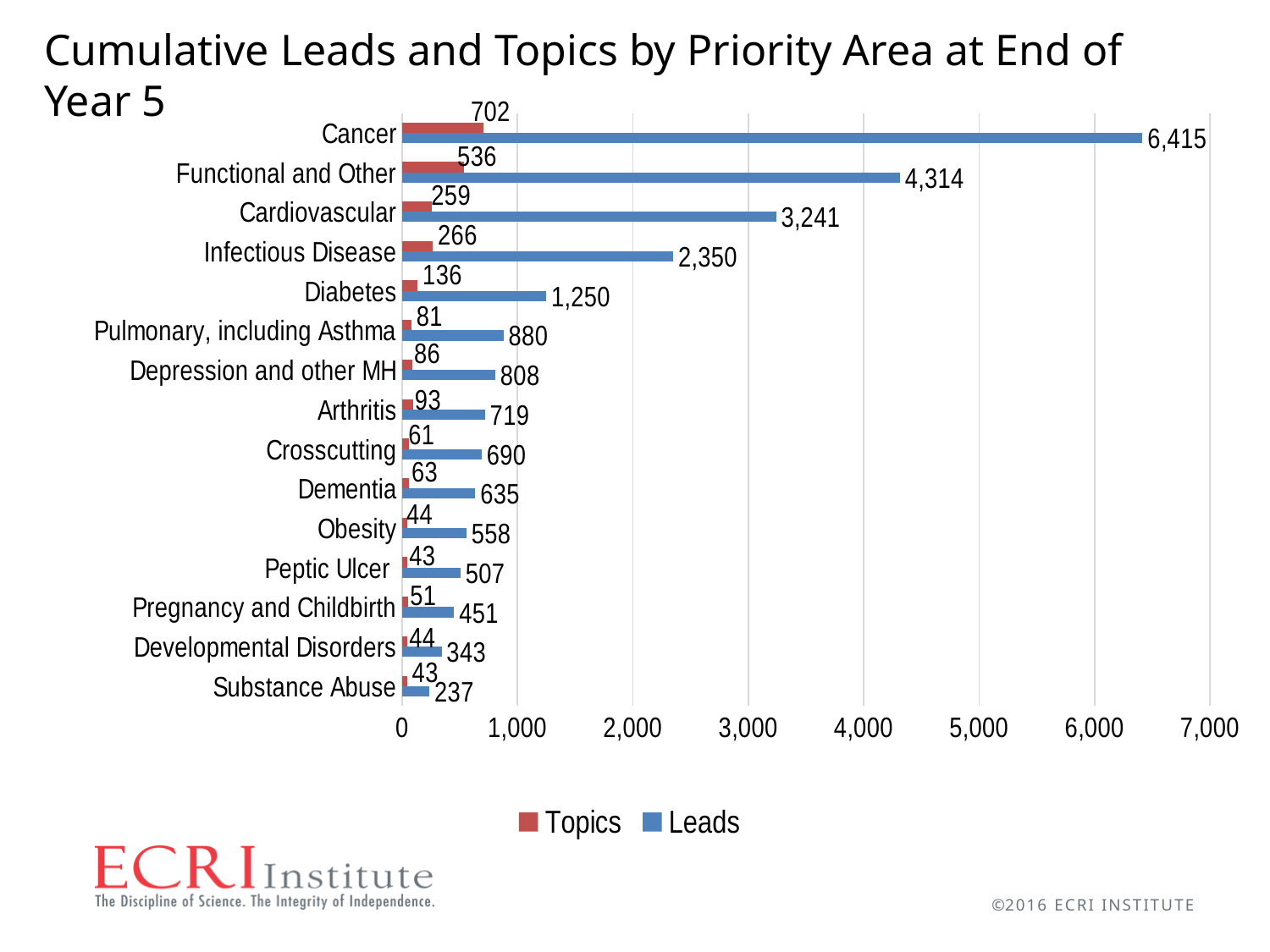
How many Leads does Substance Abuse have? 237 How many Leads does Cancer have? 6,415 What is the difference in Topics between Cardiovascular and Infectious Disease? 7 What is the difference in Leads between Cancer and Functional and Other? 2,101 Which has more Leads, Diabetes or Pulmonary, including Asthma? Diabetes Which priority area has the lowest number of Leads? Substance Abuse How many series does the legend list? 2 Which priority area has the highest number of Leads? Cancer Which has more Topics, Arthritis or Dementia? Arthritis How many Topics does Infectious Disease have? 266 How many priority areas are shown on the chart? 15 What type of chart is shown on the slide? Bar chart